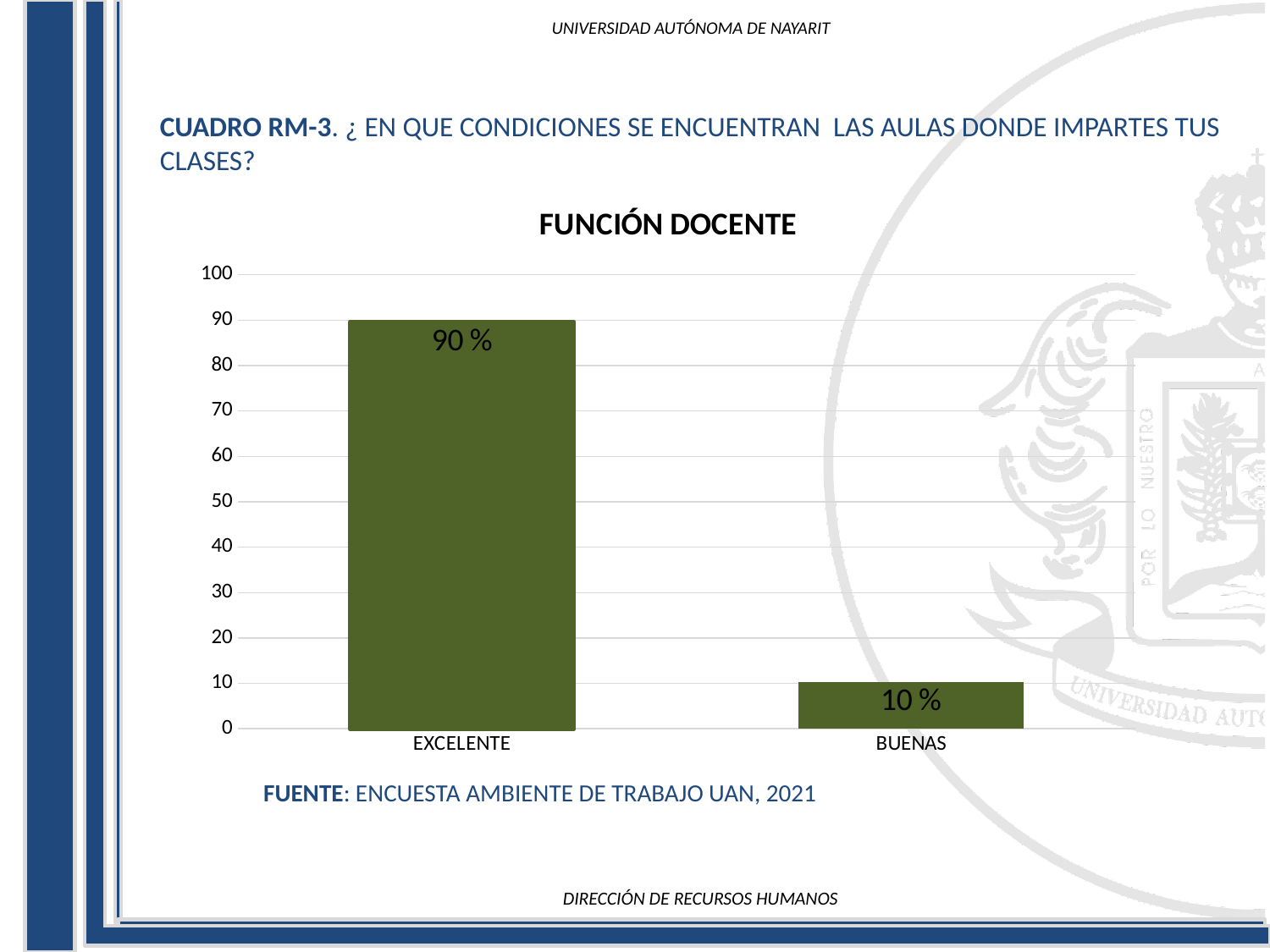
Which category has the highest value? EXCELENTE What is the difference between the values for EXCELENTE and BUENAS? 80 % Is the value for BUENAS greater or less than 20? less What is the value for BUENAS? 10 % What kind of chart is shown? bar chart What is the highest value shown on the y axis? 100 What is the title of the chart? FUNCIÓN DOCENTE Is the value for EXCELENTE greater or less than 50? greater How many categories are shown on the x axis? 2 What is the value for EXCELENTE? 90 % Which category has the lowest value? BUENAS Which is larger, the value for EXCELENTE or the value for BUENAS? EXCELENTE